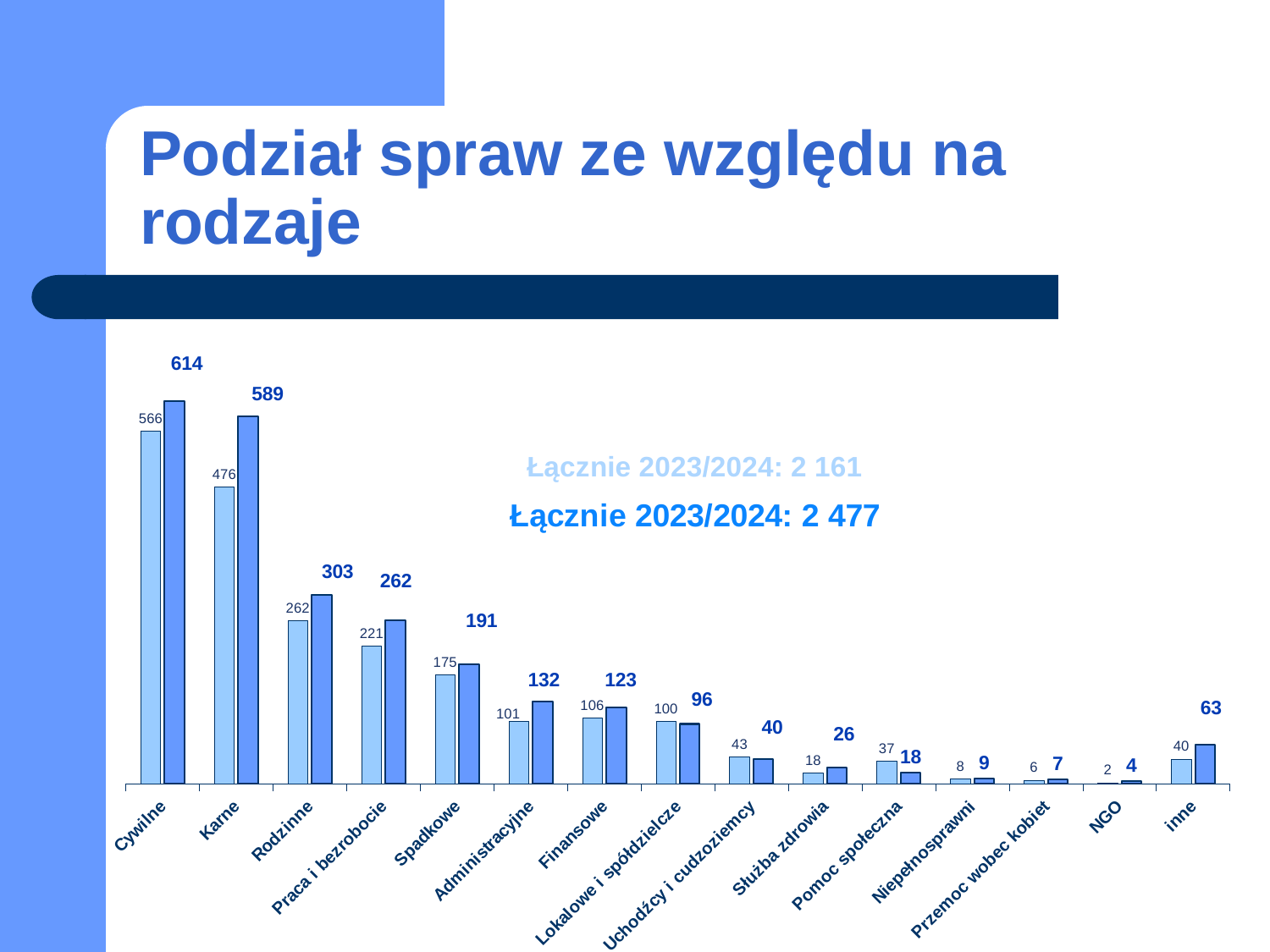
Which category has the highest dark blue bar? Cywilne Which category has the lowest light blue bar? NGO What is the difference between the dark blue and light blue bars for Karne? 113 How many categories are shown on the x axis of the chart? 15 What is the value of the light blue bar for Karne? 476 What is the value of the light blue bar for NGO? 2 For Lokalowe i spółdzielcze, which bar is larger, the light blue or the dark blue? light blue What type of chart is shown on the slide? bar chart What is the value of the dark blue bar for Spadkowe? 191 What is the value of the dark blue bar for Cywilne? 614 What is the title of the slide containing the chart? Podział spraw ze względu na rodzaje What is the difference between the dark blue bars for Rodzinne and Praca i bezrobocie? 41